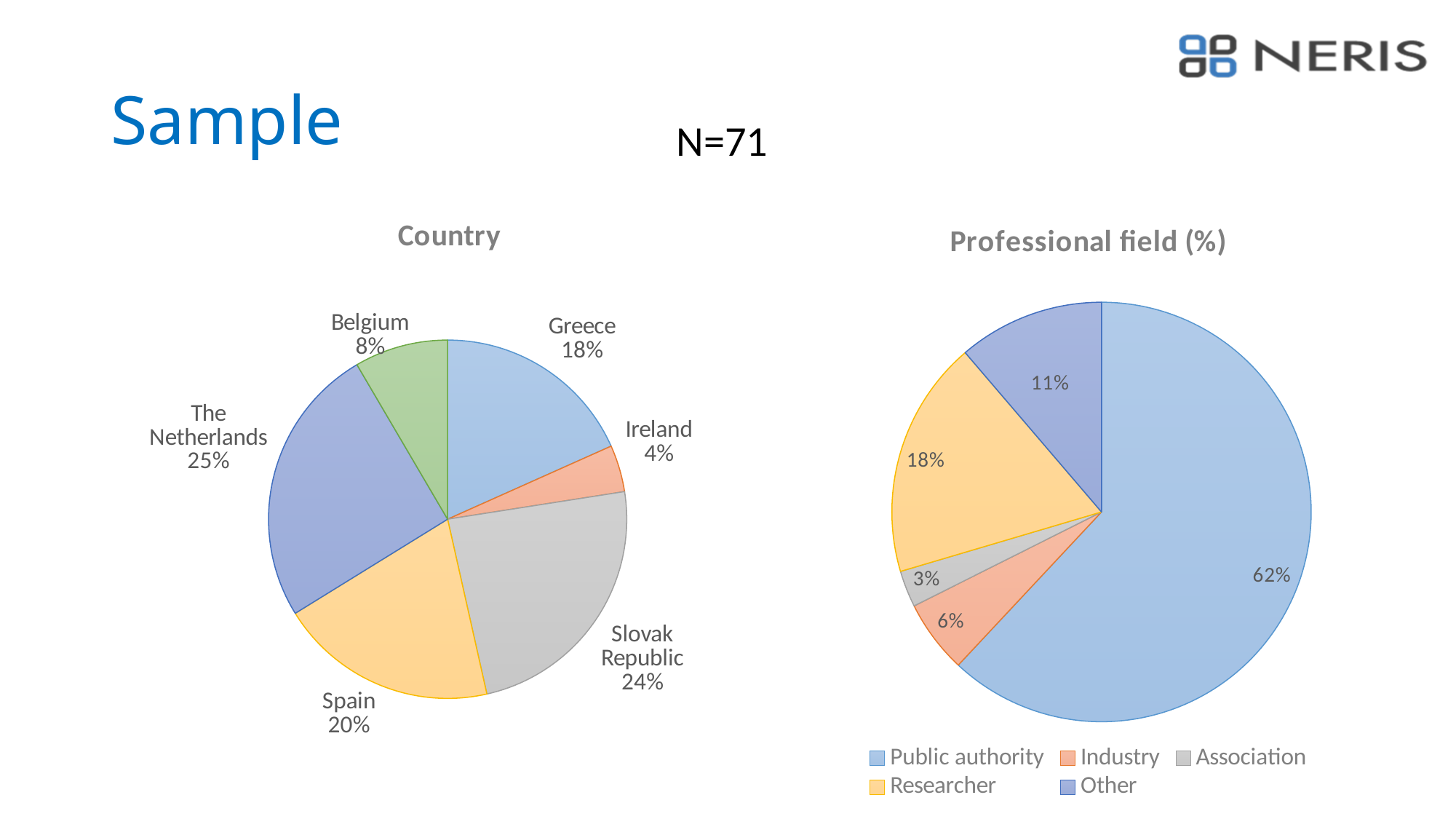
In the Country chart, how many countries are shown? 6 In the Country chart, which has a larger share, Spain or the Slovak Republic? Slovak Republic In the Country chart, what share of the sample is from Ireland? 4% What type of chart is the Professional field (%) chart? Pie chart In the Country chart, what share of the sample is from The Netherlands? 25% In the Professional field (%) chart, how many categories does the legend list? 5 In the Country chart, what is the difference between the shares of Greece and Belgium? 10% In the Professional field (%) chart, what share is Association? 3% In the Country chart, which country has the largest share? The Netherlands In the Country chart, which country has the smallest share? Ireland In the Professional field (%) chart, what is the difference between the Researcher and Industry shares? 12% In the Professional field (%) chart, what share is Public authority? 62%